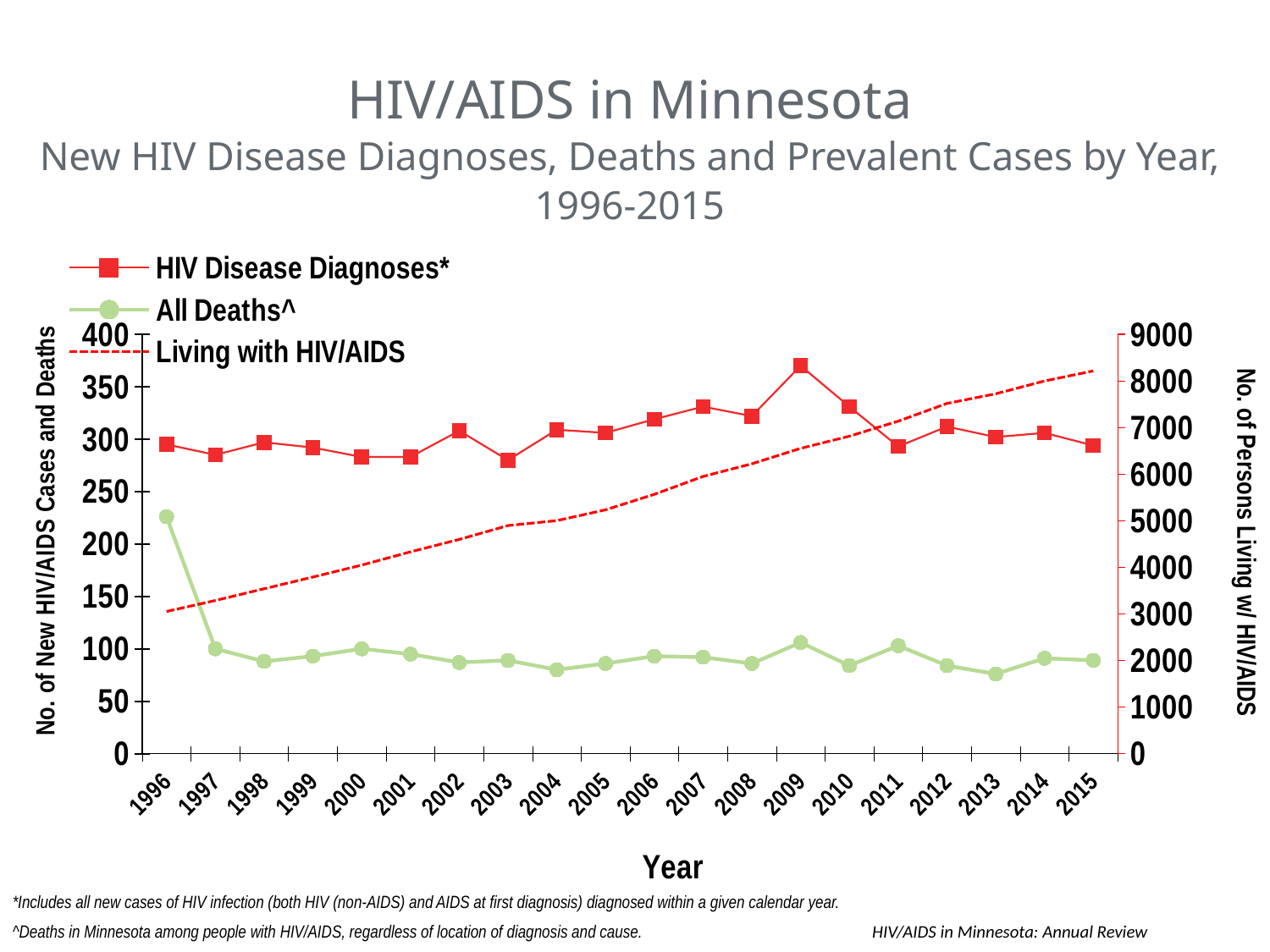
How many series does the legend list? 3 Does the Living with HIV/AIDS series rise or fall from 1996 to 2015? Rise How many years are plotted along the x axis? 20 In which year is the All Deaths series at its highest? 1996 Is the value for Living with HIV/AIDS in 1996 greater or less than 3500? less In which year is the HIV Disease Diagnoses series at its highest? 2009 Is the value for All Deaths in 1996 greater or less than 200? greater Which is larger, HIV Disease Diagnoses in 2009 or in 2010? 2009 Is the value for Living with HIV/AIDS in 2015 greater or less than 8000? greater What is the title of the right-hand vertical axis? No. of Persons Living w/ HIV/AIDS What kind of chart is shown on the slide? Line chart